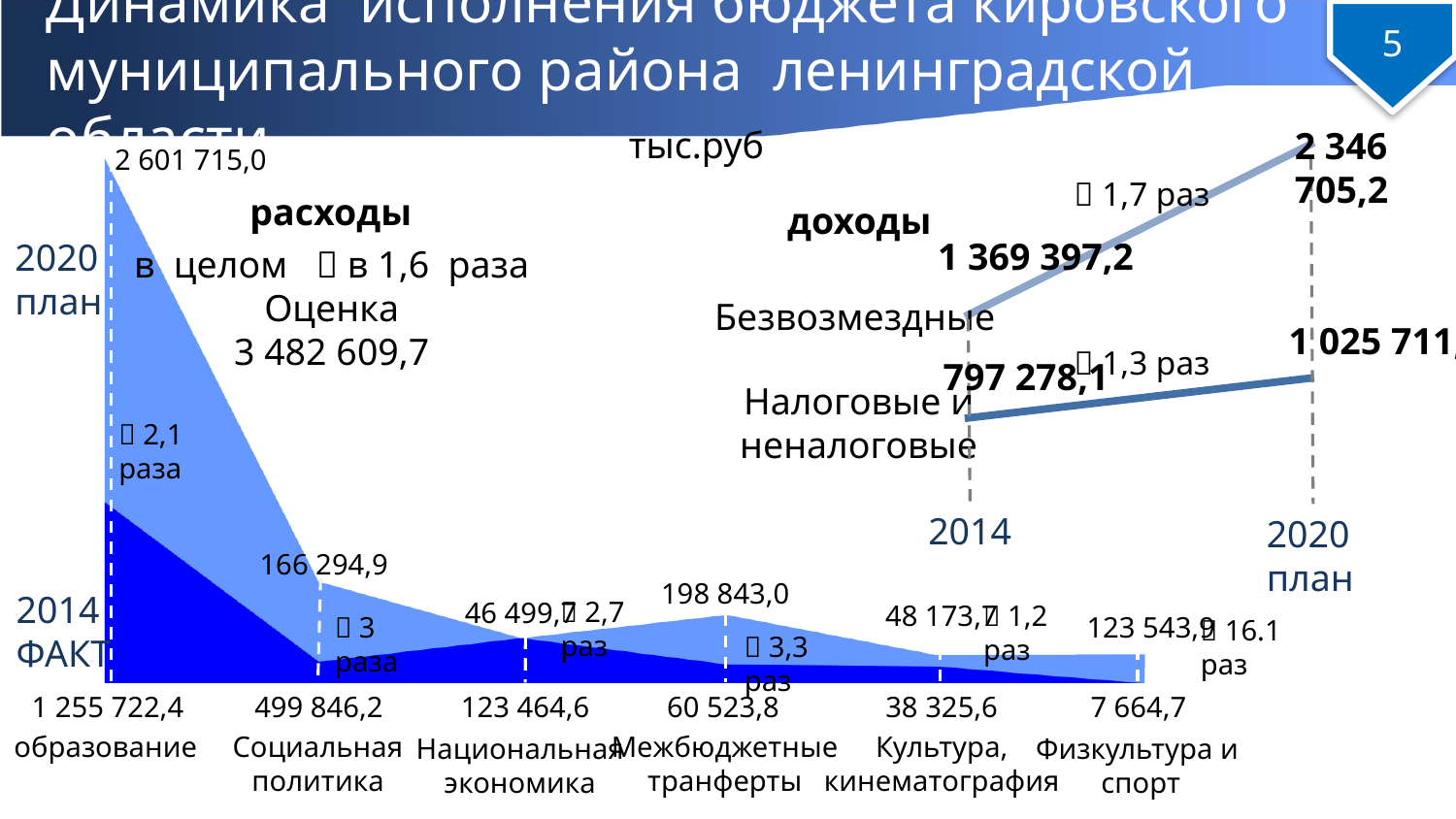
On the left area chart (расходы), what is the 2020 план value for образование? 2 601 715,0 On the right line chart (доходы), what is the 2020 план value for Безвозмездные? 2 346 705,2 On the right line chart (доходы), what is the difference between the 2020 план and 2014 values for Безвозмездные? 977 308,0 On the left area chart (расходы), what is the 2020 план value for Межбюджетные трансферты? 198 843,0 On the left area chart (расходы), which category has the highest 2014 ФАКТ value? образование On the right line chart (доходы), what is the 2014 value for Налоговые и неналоговые? 797 278,1 On the right line chart (доходы), what is the 2014 value for Безвозмездные? 1 369 397,2 On the left area chart (расходы), which category has the lowest 2014 ФАКТ value? Физкультура и спорт On the left area chart (расходы), what is the 2014 ФАКТ value for Физкультура и спорт? 7 664,7 What kind of chart is the right chart (доходы)? line chart On the left area chart (расходы), how many expense categories are shown along the x axis? 6